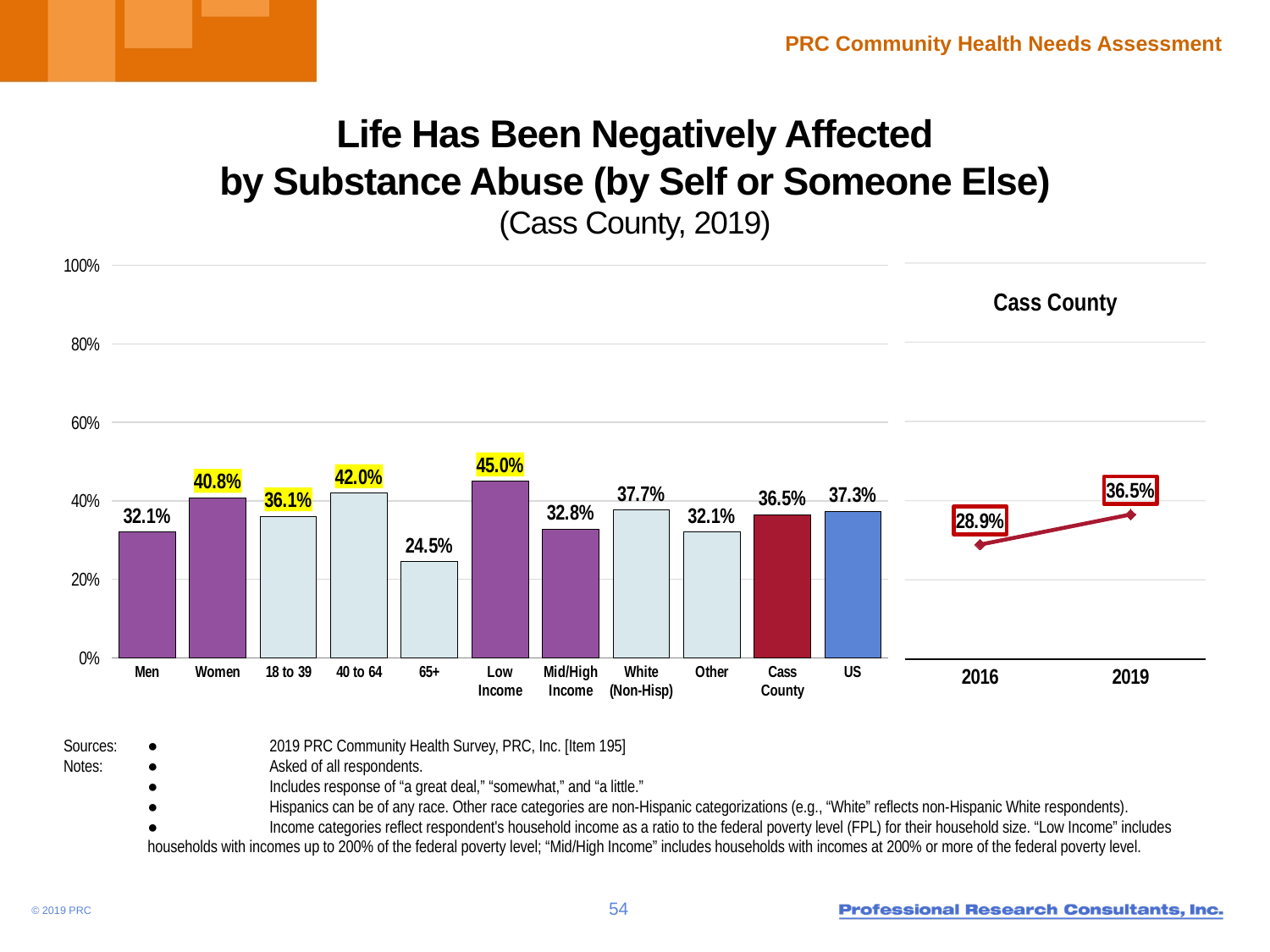
In the bar chart, is the value for 40 to 64 greater or less than 40%? greater In the bar chart, which category has the highest value? Low Income In the Cass County trend chart on the right, does the value rise or fall from 2016 to 2019? rise In the Cass County trend chart on the right, what is the value for 2016? 28.9% In the bar chart, what is the value for Women? 40.8% In the bar chart, what is the value for Low Income? 45.0% In the bar chart, which is larger, the value for Women or the value for Men? Women In the bar chart, which category has the lowest value? 65+ In the bar chart, what is the difference between the Cass County and US values? 0.8 percentage points How many categories are shown in the bar chart? 11 What kind of chart is the Cass County chart on the right? line chart In the bar chart, what is the value for 65+? 24.5%